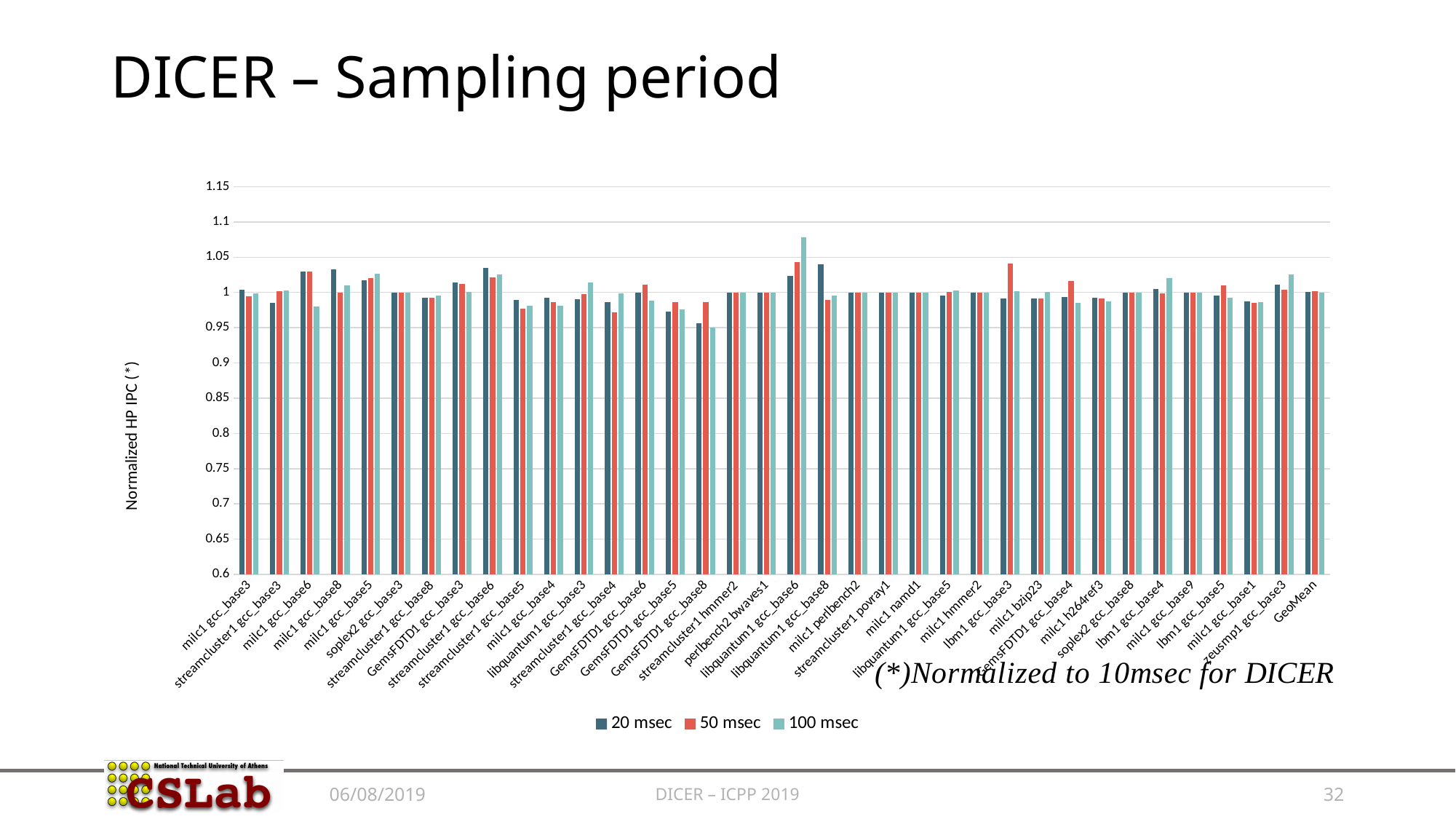
What are the three series named in the legend? 20 msec, 50 msec, 100 msec What kind of chart is shown on the slide? bar chart For milc1 gcc_base6, which is larger: the 20 msec value or the 100 msec value? 20 msec Is the 20 msec value for GemsFDTD1 gcc_base5 greater or less than 1? less Which category has the highest 100 msec value? libquantum1 gcc_base6 Is the 100 msec value for libquantum1 gcc_base6 greater or less than 1.05? greater Which category has the lowest 100 msec value? GemsFDTD1 gcc_base8 How many series does the legend list? 3 Is the 20 msec value for milc1 gcc_base6 greater or less than 1? greater What is the label of the vertical axis? Normalized HP IPC (*)